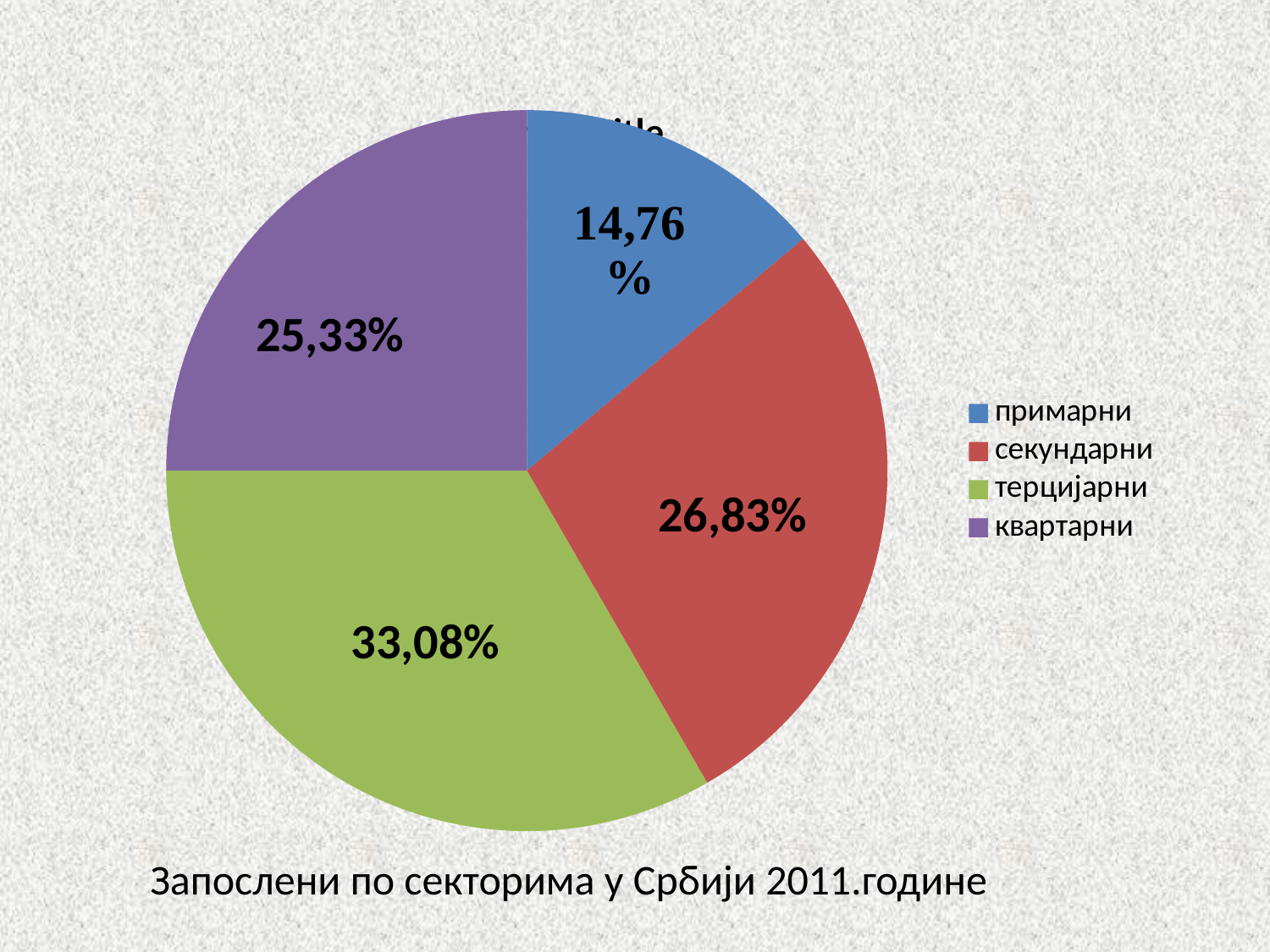
What is the value shown for the квартарни slice? 25,33% What is the difference between the терцијарни share and the примарни share? 18,32% What is the value shown for the терцијарни slice? 33,08% How many entries does the legend list? 4 What kind of chart is shown on the slide? pie chart What colour is the квартарни slice? purple Which sector has the largest share of the pie? терцијарни How many slices does the pie chart have? 4 Which sector has the smallest share of the pie? примарни Which is larger, the share for секундарни or the share for квартарни? секундарни What is the value shown for the секундарни slice? 26,83% What is the value shown for the примарни slice? 14,76%